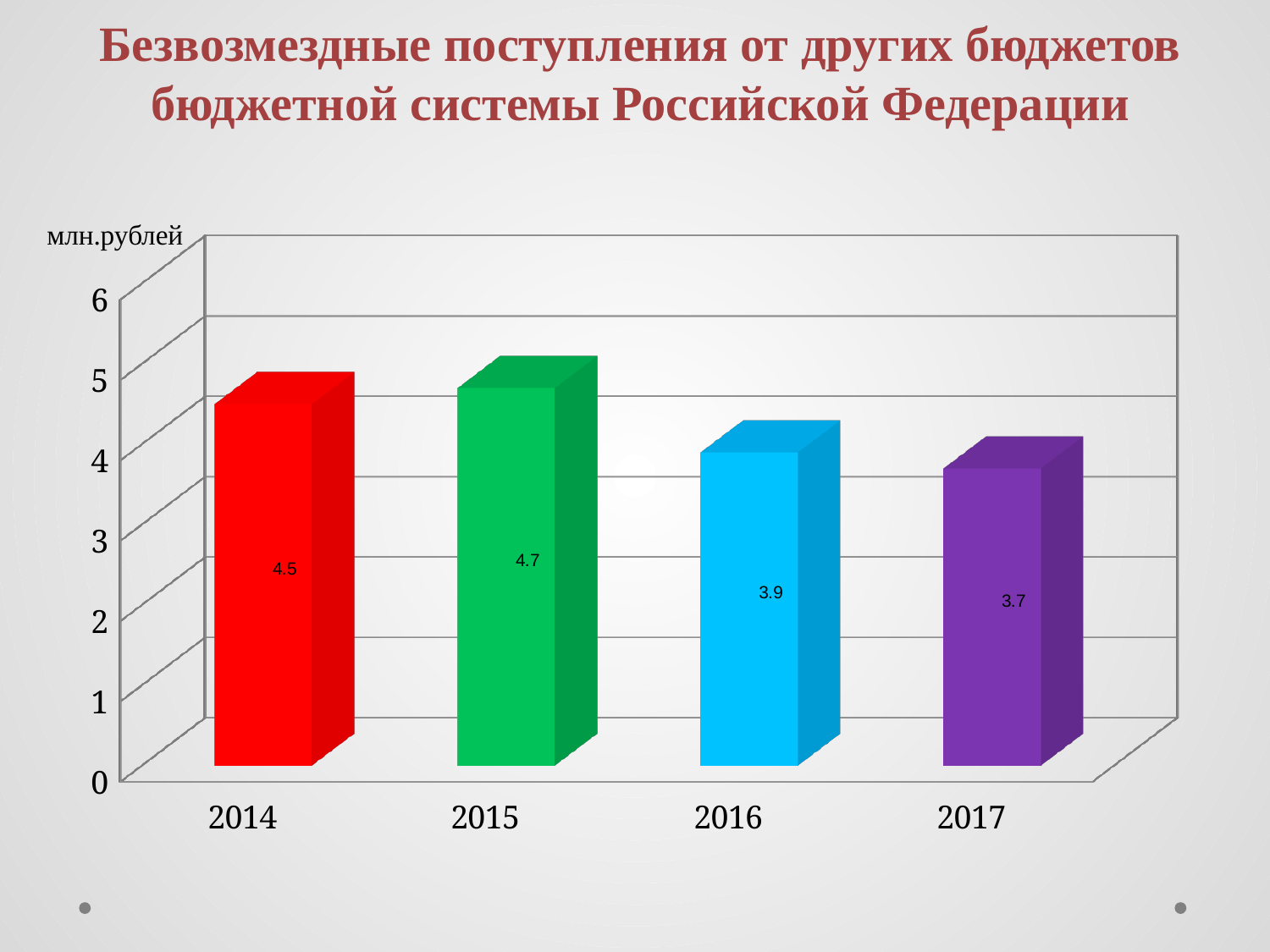
What unit is shown on the vertical axis of the chart? млн.рублей Which year has the lowest value? 2017 How many years are shown on the chart? 4 What is the value for 2016? 3.9 What kind of chart is shown on the slide? bar chart Which year has the highest value? 2015 What is the value for 2017? 3.7 Is the value for 2016 greater or less than 4? less What is the value for 2014? 4.5 Which is larger, the value for 2014 or the value for 2016? 2014 What is the value for 2015? 4.7 What is the difference between the values for 2015 and 2017? 1.0